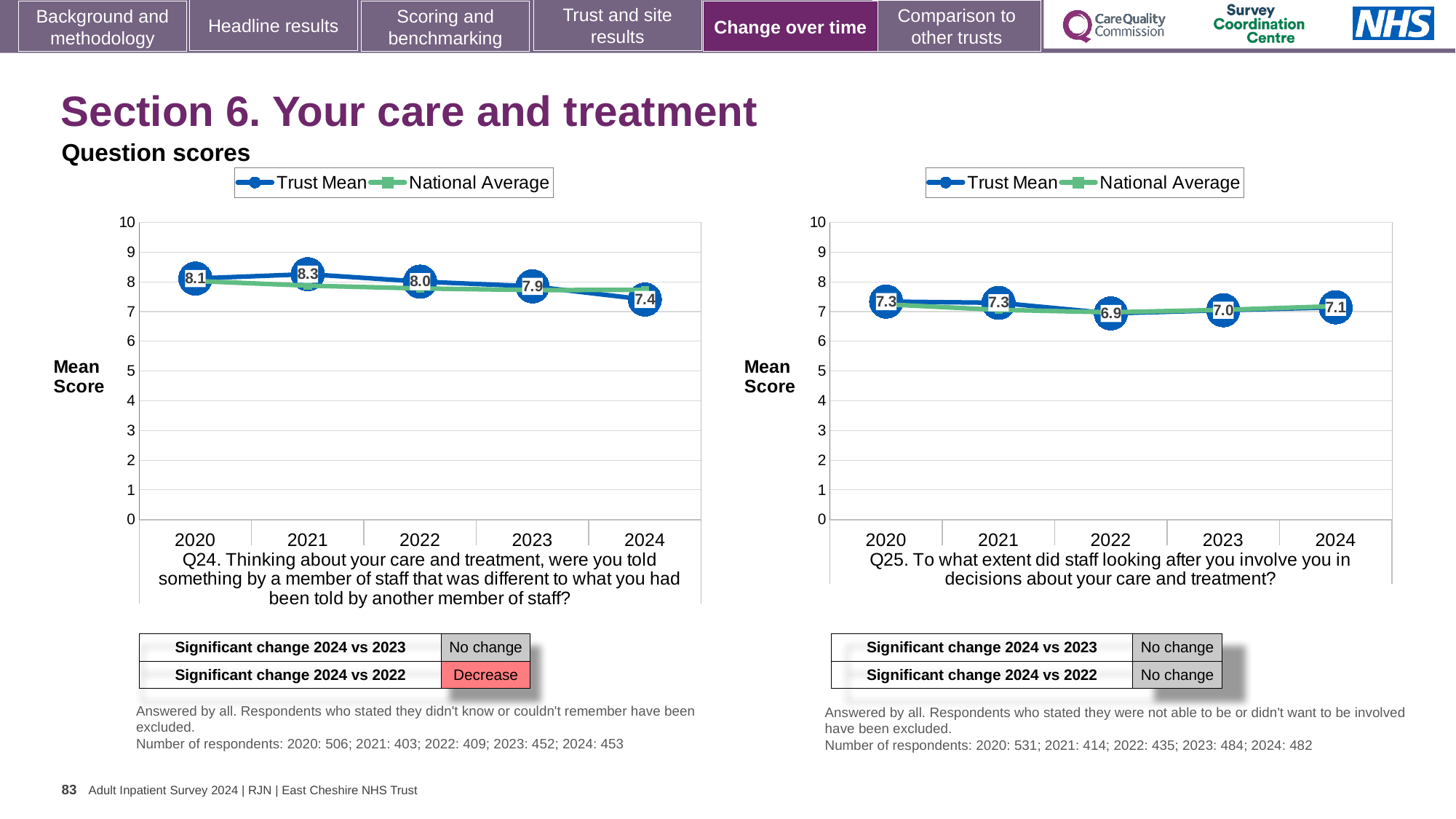
In the Q24 chart on the left, what is the Trust Mean score for 2021? 8.3 In the Q24 chart on the left, is the National Average for 2024 greater or less than 7? greater In the Q24 chart on the left, does the Trust Mean score rise or fall between 2021 and 2024? fall In the Q24 chart on the left, what is the Trust Mean score for 2024? 7.4 In the Q25 chart on the right, what is the difference between the Trust Mean scores for 2020 and 2022? 0.4 In the Q25 chart on the right, which year has the lowest Trust Mean score? 2022 In the Q25 chart on the right, is the Trust Mean score higher in 2022 or in 2024? 2024 In the Q24 chart on the left, which year has the highest Trust Mean score? 2021 How many series does the legend of the Q25 chart on the right list? 2 In the Q24 chart on the left, which year has the lowest Trust Mean score? 2024 In the Q24 chart on the left, what is the difference between the Trust Mean scores for 2021 and 2024? 0.9 In the Q25 chart on the right, what is the Trust Mean score for 2022? 6.9